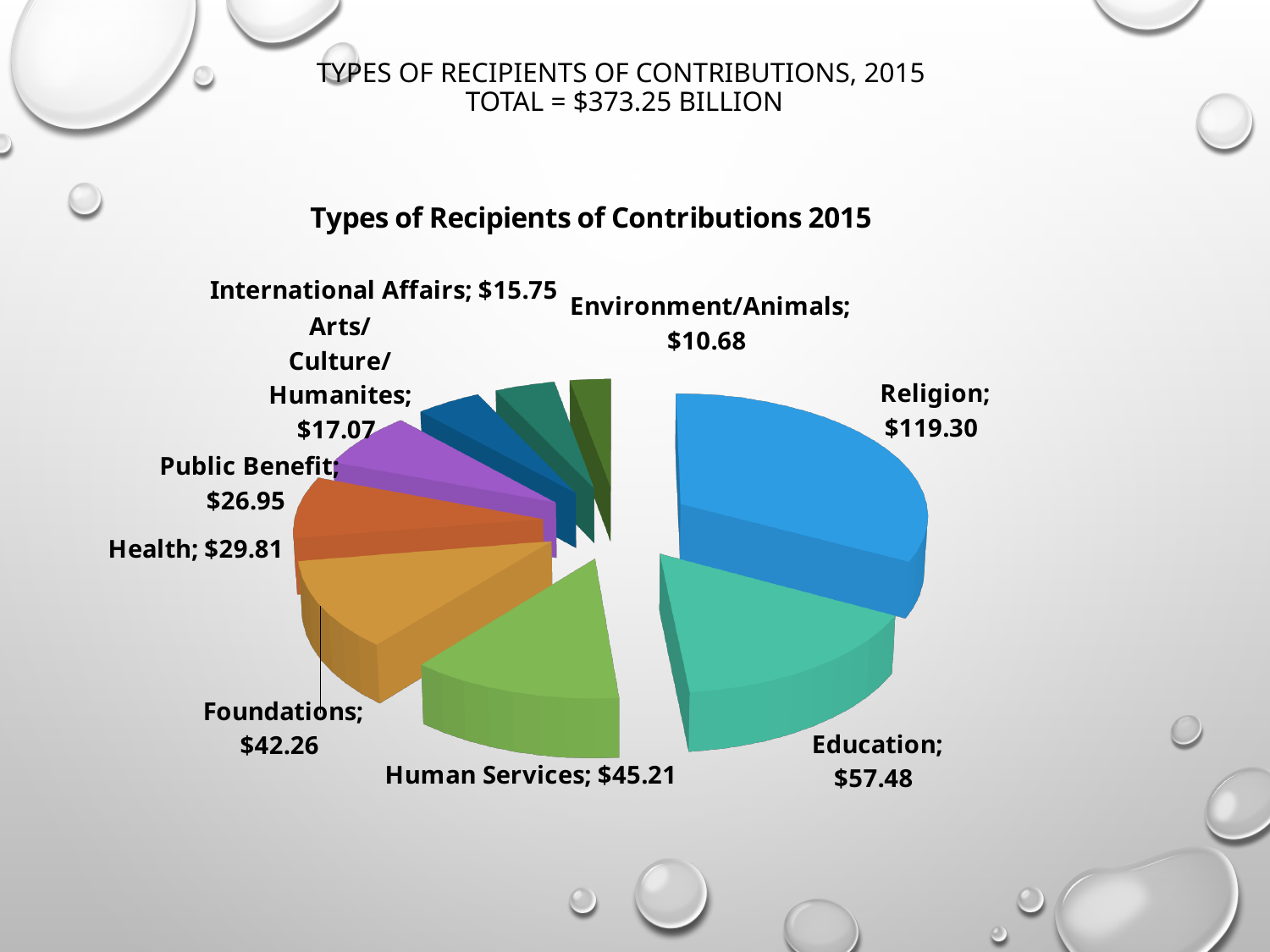
Which is larger, the value for Foundations or the value for Human Services? Human Services What is the value for Public Benefit? $26.95 What is the difference between the values for Health and Public Benefit? $2.86 What is the value for Religion? $119.30 What is the difference between the values for Religion and Education? $61.82 How many categories are shown in the pie chart? 9 What is the title of the chart? Types of Recipients of Contributions 2015 Which category has the largest slice of the pie? Religion What type of chart is shown on the slide? Pie chart Which category has the smallest slice of the pie? Environment/Animals What is the value for Human Services? $45.21 What is the value for Environment/Animals? $10.68